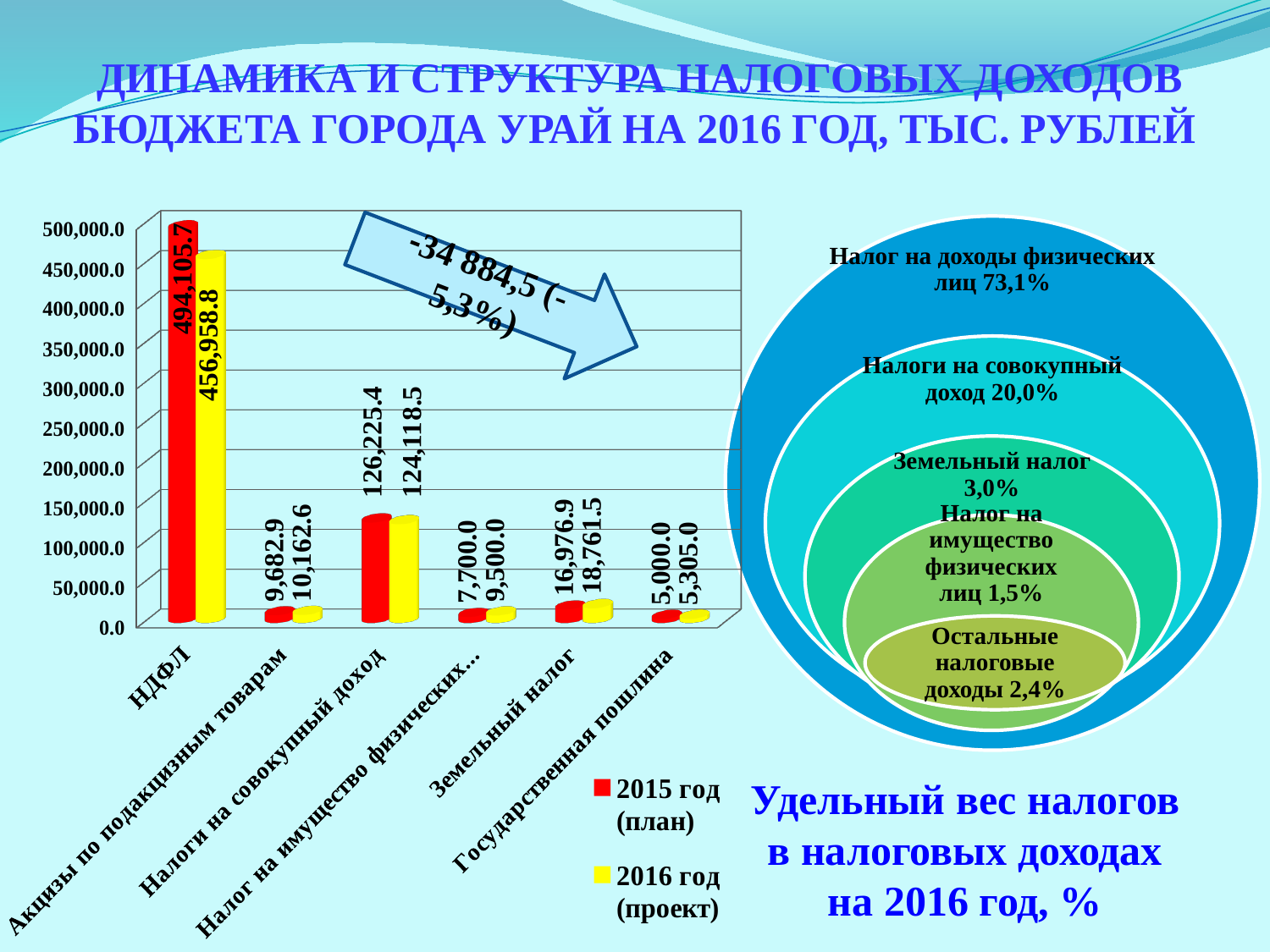
What type of chart is shown on the left of the slide? Bar chart In the bar chart, is the 2015 год (план) value for Налоги на совокупный доход greater or less than 100,000.0? greater In the bar chart, what is the 2015 год (план) value for НДФЛ? 494,105.7 In the bar chart, which category has the lowest 2015 год (план) value? Государственная пошлина In the bar chart, what is the 2015 год (план) value for Государственная пошлина? 5,000.0 How many series does the legend of the bar chart list? 2 In the bar chart, which category has the highest 2016 год (проект) value? НДФЛ In the bar chart, which is larger for Акцизы по подакцизным товарам: the 2015 год (план) value or the 2016 год (проект) value? 2016 год (проект) How many categories are shown on the x axis of the bar chart? 6 In the bar chart, what is the 2016 год (проект) value for Земельный налог? 18,761.5 In the bar chart, what is the difference between the 2015 год (план) and 2016 год (проект) values for НДФЛ? 37,146.9 In the bar chart, what is the 2016 год (проект) value for Налоги на совокупный доход? 124,118.5